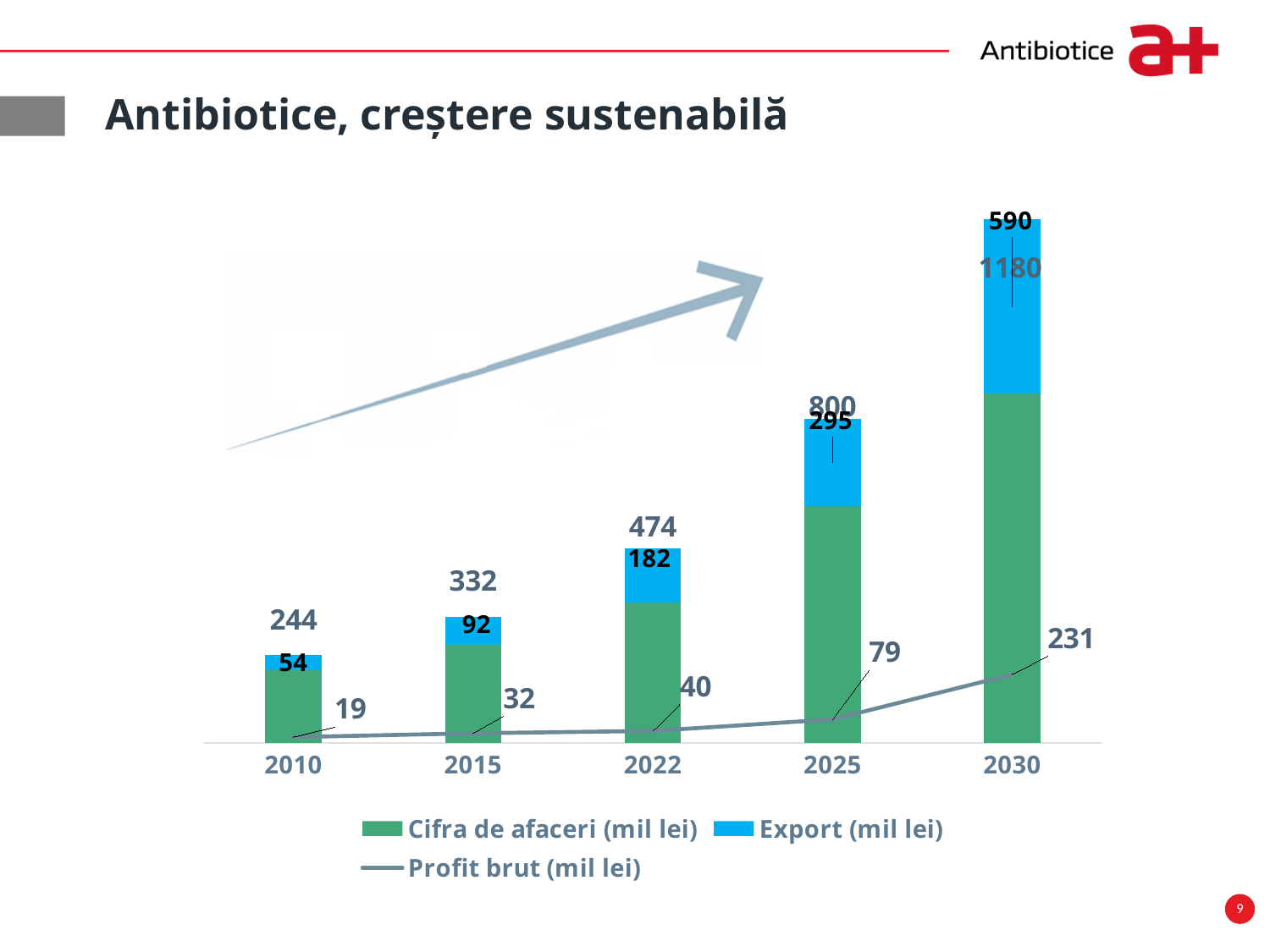
What is the Cifra de afaceri (mil lei) value for 2022? 474 What is the Profit brut (mil lei) value for 2015? 32 How many series does the legend list? 3 Which is larger, the Export (mil lei) value for 2015 or for 2022? 2022 What is the difference between the Cifra de afaceri (mil lei) values for 2025 and 2022? 326 Which year has the lowest Export (mil lei)? 2010 What is the Cifra de afaceri (mil lei) value for 2030? 1180 Which year has the highest Profit brut (mil lei)? 2030 Do the Profit brut (mil lei) values rise or fall from 2010 to 2030? rise How many years are shown on the x axis? 5 What is the title of the slide? Antibiotice, creștere sustenabilă What is the Export (mil lei) value for 2025? 295